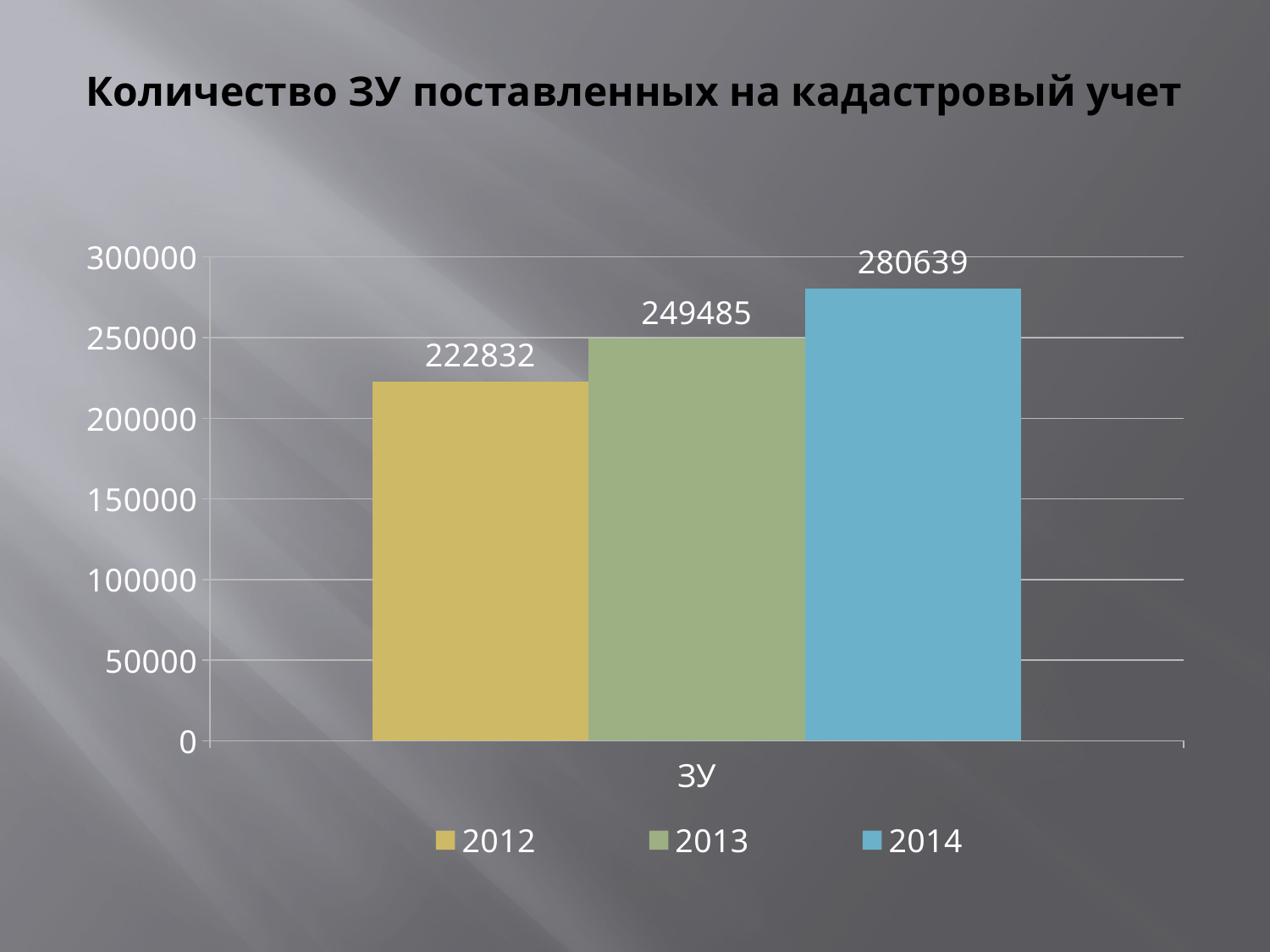
How many series does the legend list? 3 Which is larger, the value for 2013 or the value for 2014? 2014 What is the value for 2014? 280639 What is the title of the chart? Количество ЗУ поставленных на кадастровый учет What is the difference between the values for 2014 and 2012? 57807 Which year has the lowest value? 2012 Is the value for 2014 greater or less than 250000? greater What is the value for 2013? 249485 What is the value for 2012? 222832 What kind of chart is shown on the slide? bar chart Which year has the highest value? 2014 What is the difference between the values for 2013 and 2012? 26653